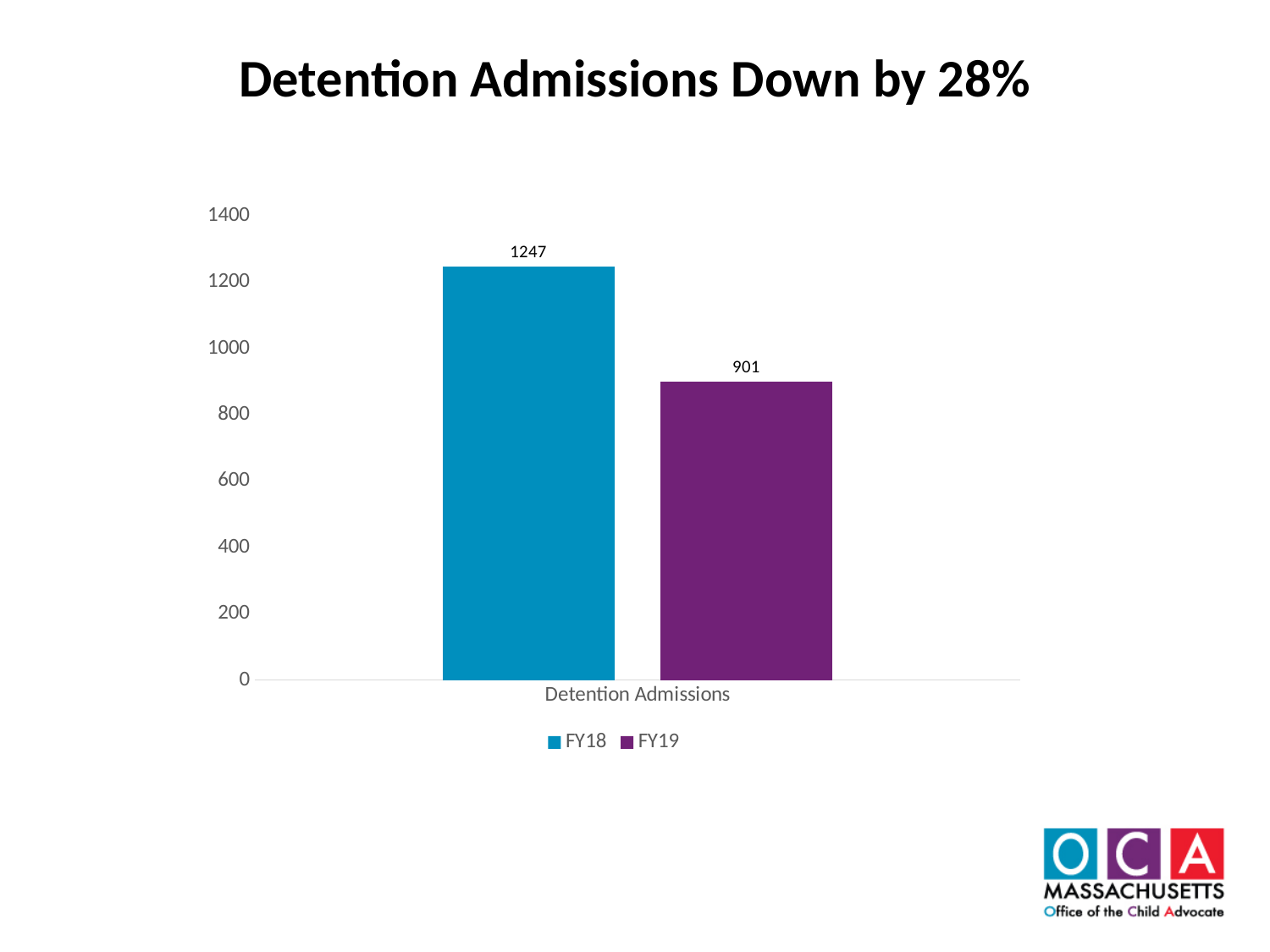
What is the category label on the x axis? Detention Admissions What is the value for FY18 detention admissions? 1247 What is the difference between the FY18 and FY19 values? 346 Is the value for FY19 greater or less than 1000? less What is the value for FY19 detention admissions? 901 Which series has the higher value, FY18 or FY19? FY18 How many series does the legend list? 2 Which series has the lowest value? FY19 What kind of chart is shown on the slide? bar chart What is the title of the slide? Detention Admissions Down by 28% Is the value for FY18 greater or less than 1200? greater Do the values rise or fall from FY18 to FY19? fall